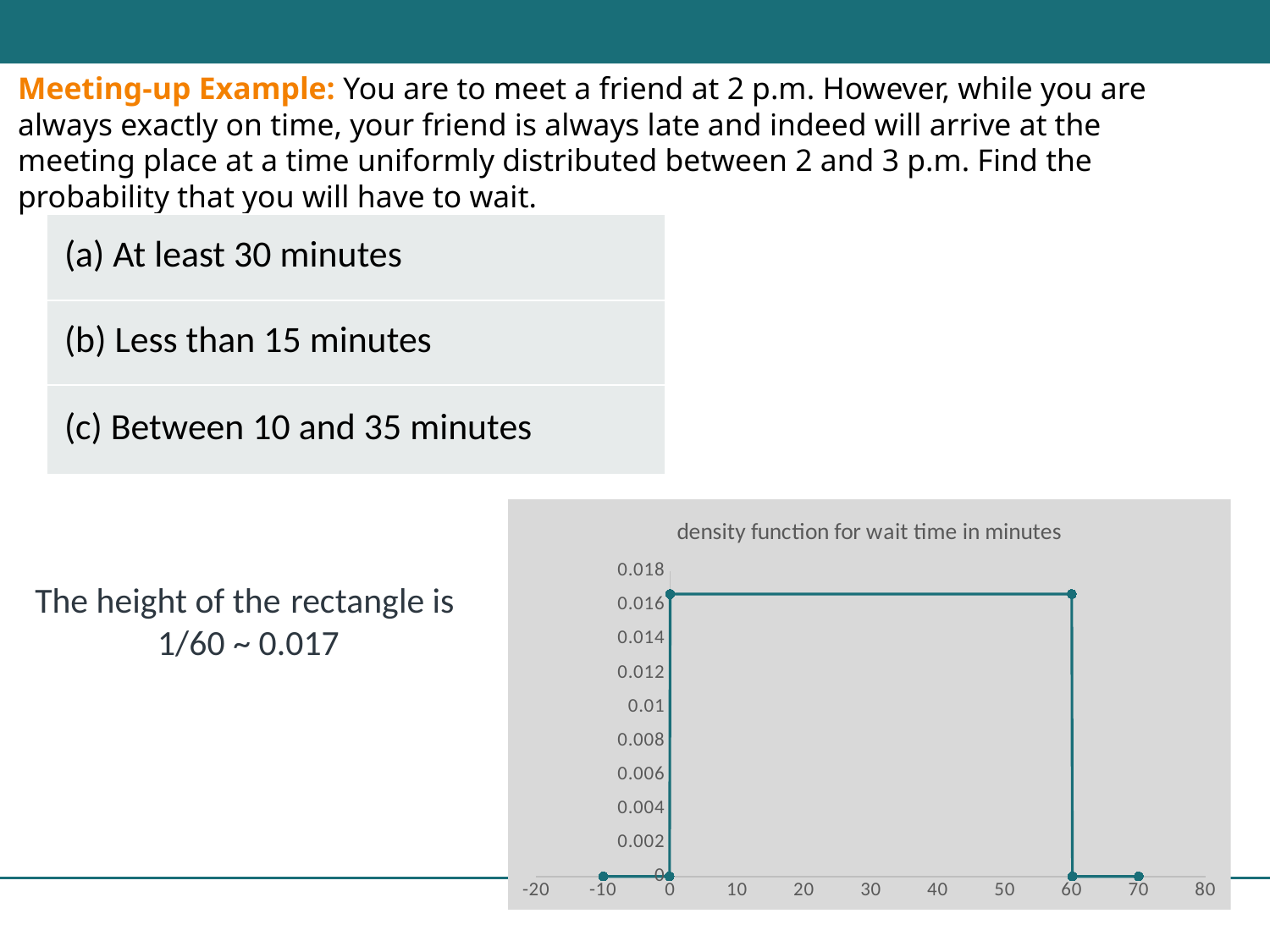
At which wait time does the density drop from its plateau back to 0? 60 What kind of chart is shown on the slide? line chart Is the density value at a wait time of 30 minutes greater or less than 0.01? greater What is the highest value labelled on the vertical axis? 0.018 What is the density value at a wait time of 70 minutes? 0 Is the density value at a wait time of 30 minutes greater or less than 0.018? less Does the density value rise, fall, or stay flat between wait times of 0 and 60 minutes? stay flat What is the title of the chart? density function for wait time in minutes Which has the larger density value: a wait time of 30 minutes or a wait time of 70 minutes? 30 minutes Is the density value at a wait time of 70 minutes greater or less than 0.01? less How many data point markers are plotted on the chart? 6 What is the density value at a wait time of -10 minutes? 0